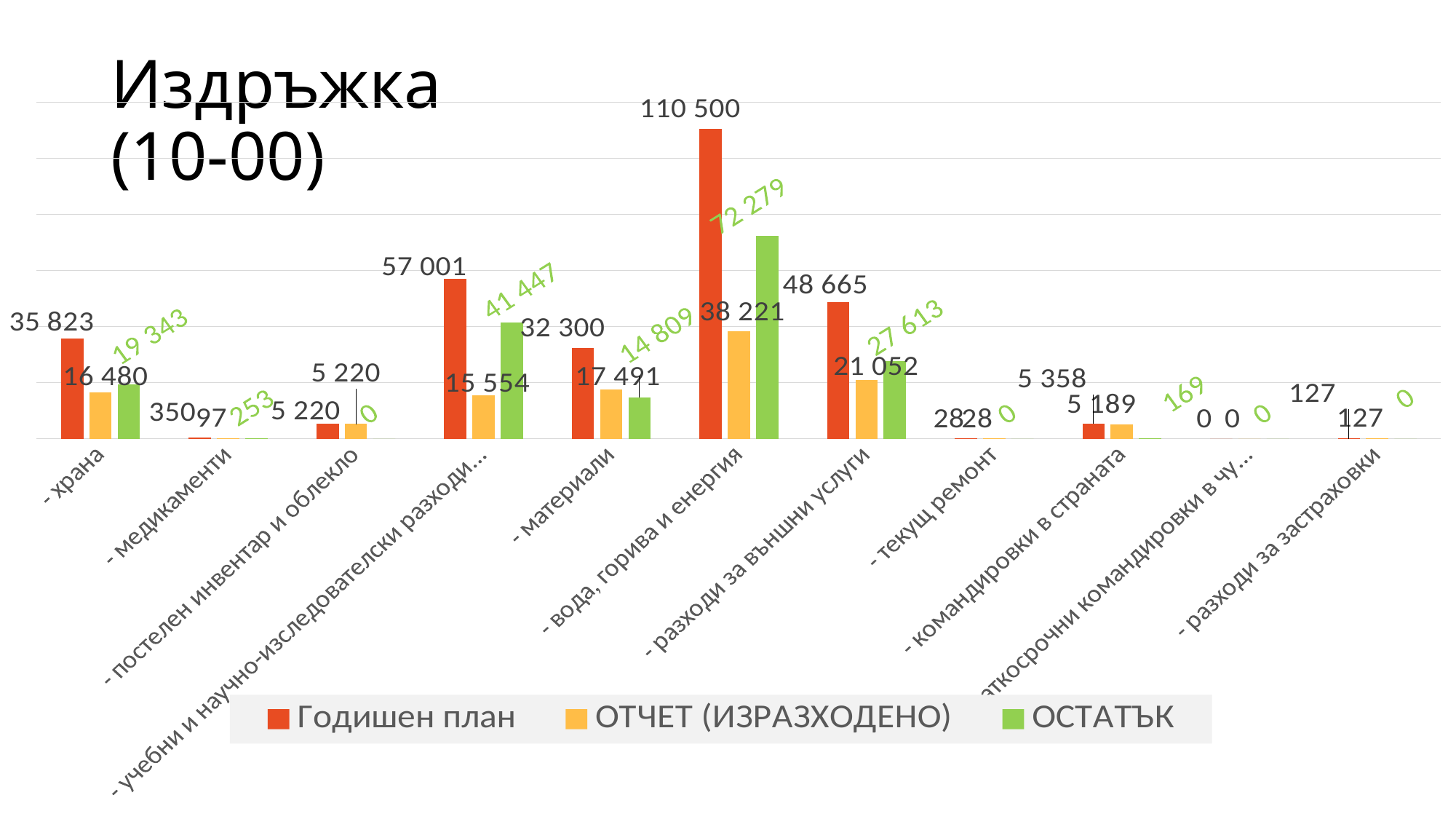
What is the difference between the Годишен план and ОТЧЕТ (ИЗРАЗХОДЕНО) values for материали? 14 809 How many categories are shown on the x axis? 11 Which colour represents the ОСТАТЪК series? green What is the ОСТАТЪК value for разходи за външни услуги? 27 613 What is the ОСТАТЪК value for командировки в страната? 169 What is the ОТЧЕТ (ИЗРАЗХОДЕНО) value for храна? 16 480 Which category has the highest Годишен план value? вода, горива и енергия Which is larger for храна: the ОТЧЕТ (ИЗРАЗХОДЕНО) value or the ОСТАТЪК value? ОСТАТЪК How many series does the legend list? 3 What is the title of the chart? Издръжка (10-00) What kind of chart is shown on the slide? bar chart What is the Годишен план value for вода, горива и енергия? 110 500